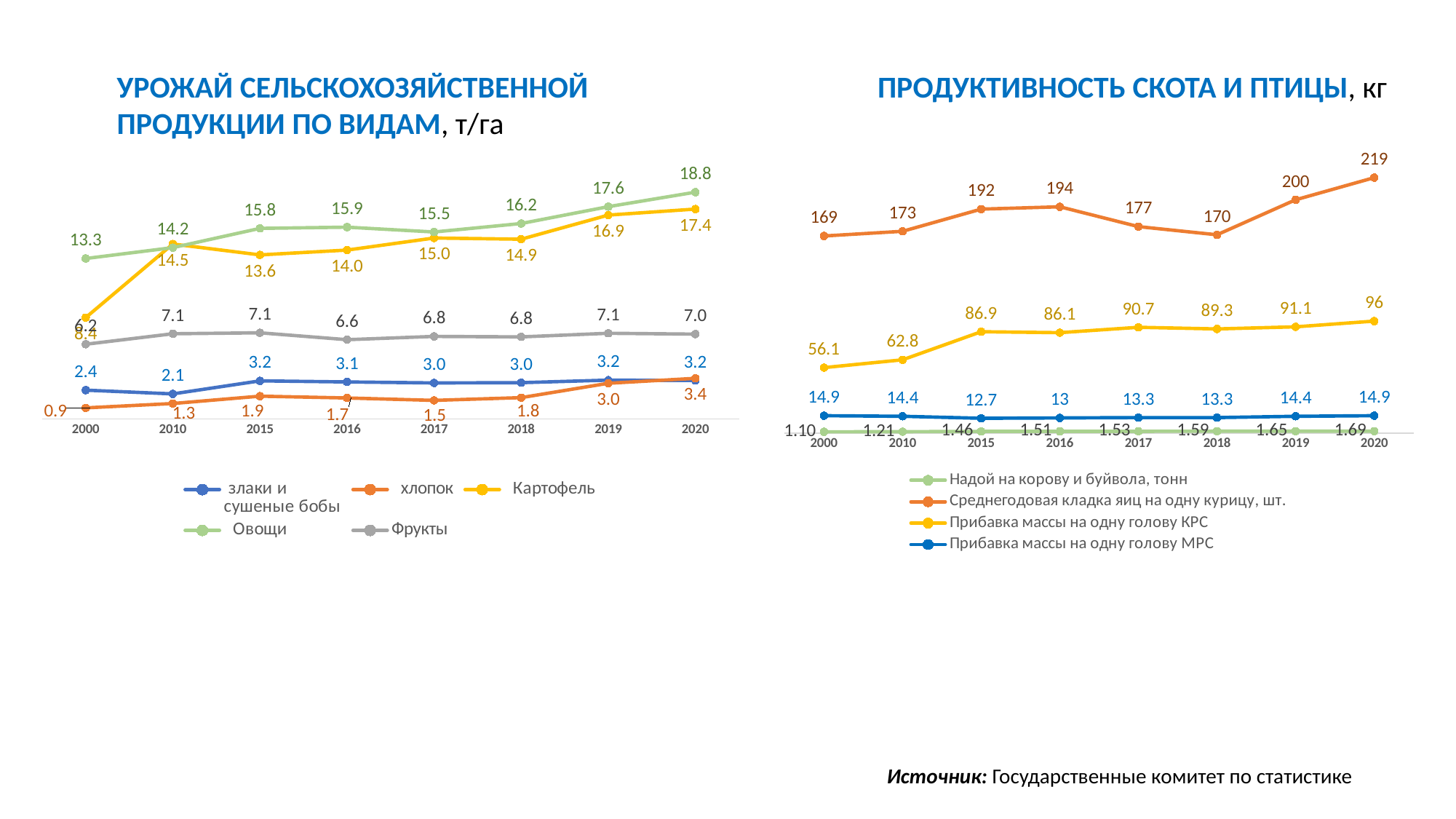
What type of chart is the right chart (ПРОДУКТИВНОСТЬ СКОТА И ПТИЦЫ)? line chart On the left chart (УРОЖАЙ СЕЛЬСКОХОЗЯЙСТВЕННОЙ ПРОДУКЦИИ ПО ВИДАМ), what is the value for Овощи in 2020? 18.8 On the right chart (ПРОДУКТИВНОСТЬ СКОТА И ПТИЦЫ), how many years are shown on the x axis? 8 On the right chart (ПРОДУКТИВНОСТЬ СКОТА И ПТИЦЫ), does the Надой на корову и буйвола series rise or fall from 2000 to 2020? rise On the left chart (УРОЖАЙ СЕЛЬСКОХОЗЯЙСТВЕННОЙ ПРОДУКЦИИ ПО ВИДАМ), what is the difference between the Овощи value in 2020 and in 2000? 5.5 On the left chart (УРОЖАЙ СЕЛЬСКОХОЗЯЙСТВЕННОЙ ПРОДУКЦИИ ПО ВИДАМ), how many series does the legend list? 5 On the left chart (УРОЖАЙ СЕЛЬСКОХОЗЯЙСТВЕННОЙ ПРОДУКЦИИ ПО ВИДАМ), which is larger in 2020: злаки и сушеные бобы or хлопок? хлопок On the left chart (УРОЖАЙ СЕЛЬСКОХОЗЯЙСТВЕННОЙ ПРОДУКЦИИ ПО ВИДАМ), in which year is the Картофель value highest? 2020 On the right chart (ПРОДУКТИВНОСТЬ СКОТА И ПТИЦЫ), in which year is the Прибавка массы на одну голову МРС value lowest? 2015 On the left chart (УРОЖАЙ СЕЛЬСКОХОЗЯЙСТВЕННОЙ ПРОДУКЦИИ ПО ВИДАМ), what is the value for хлопок in 2000? 0.9 On the right chart (ПРОДУКТИВНОСТЬ СКОТА И ПТИЦЫ), what is the value for Среднегодовая кладка яиц на одну курицу in 2020? 219 On the right chart (ПРОДУКТИВНОСТЬ СКОТА И ПТИЦЫ), what is the difference between the Прибавка массы на одну голову КРС value in 2020 and in 2000? 39.9